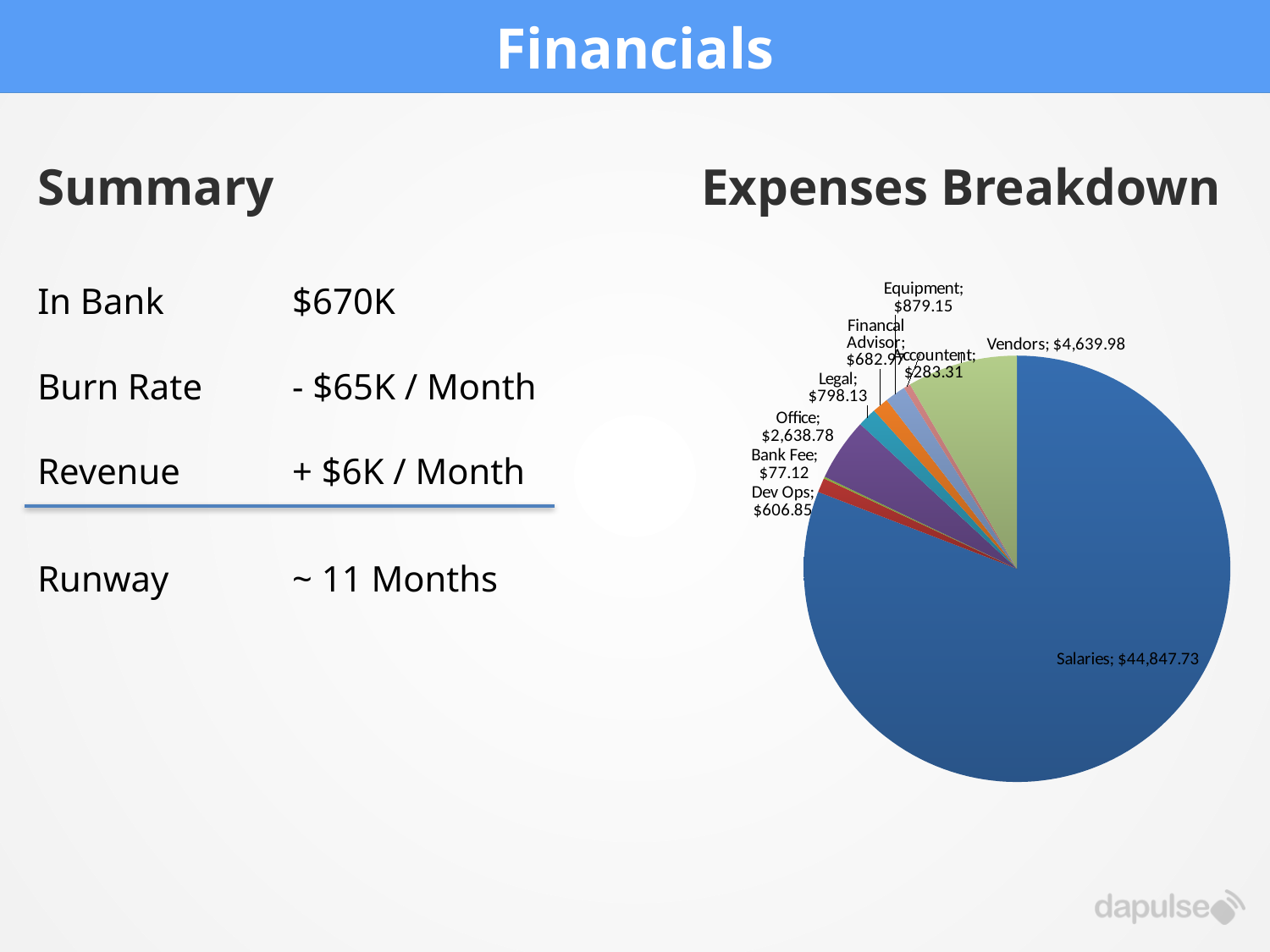
In the Expenses Breakdown pie chart, what is the value for Office? $2,638.78 In the Expenses Breakdown pie chart, what is the difference between Vendors and Office? $2,001.20 In the Expenses Breakdown pie chart, what is the value for Vendors? $4,639.98 How many categories are shown in the Expenses Breakdown pie chart? 9 Which category has the smallest slice in the Expenses Breakdown pie chart? Bank Fee In the Expenses Breakdown pie chart, what is the value for Dev Ops? $606.85 What is the title of the chart on the slide? Expenses Breakdown What kind of chart is shown under Expenses Breakdown? Pie chart In the Expenses Breakdown pie chart, what is the value for Bank Fee? $77.12 In the Expenses Breakdown pie chart, what is the value for Salaries? $44,847.73 In the Expenses Breakdown pie chart, which is larger: Equipment or Legal? Equipment Which category has the largest slice in the Expenses Breakdown pie chart? Salaries